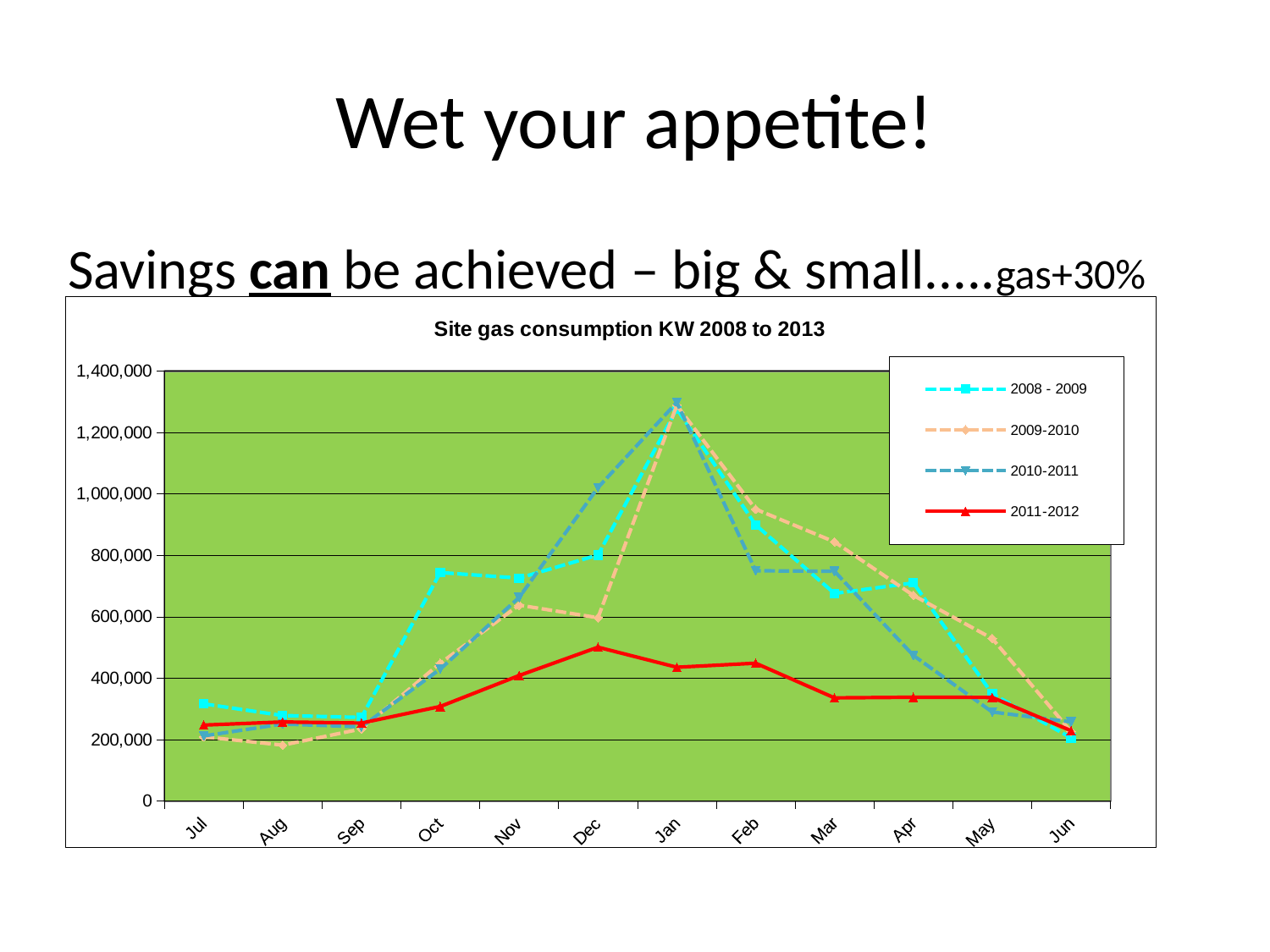
In which month does the 2011-2012 series reach its highest value? Dec Is the value for 2009-2010 in Feb greater or less than 800,000? greater What colour is the 2011-2012 line? red In Dec, which series has the larger value: 2010-2011 or 2008 - 2009? 2010-2011 Is the value for 2008 - 2009 in Jan greater or less than 1,200,000? greater What is the title of the chart? Site gas consumption KW 2008 to 2013 Does the 2008 - 2009 series rise or fall from Jan to Jun? fall In which month does the 2009-2010 series reach its lowest value? Aug How many months are shown along the x axis? 12 What kind of chart is shown on the slide? line chart Is the value for 2011-2012 in Dec greater or less than 600,000? less How many series does the legend list? 4